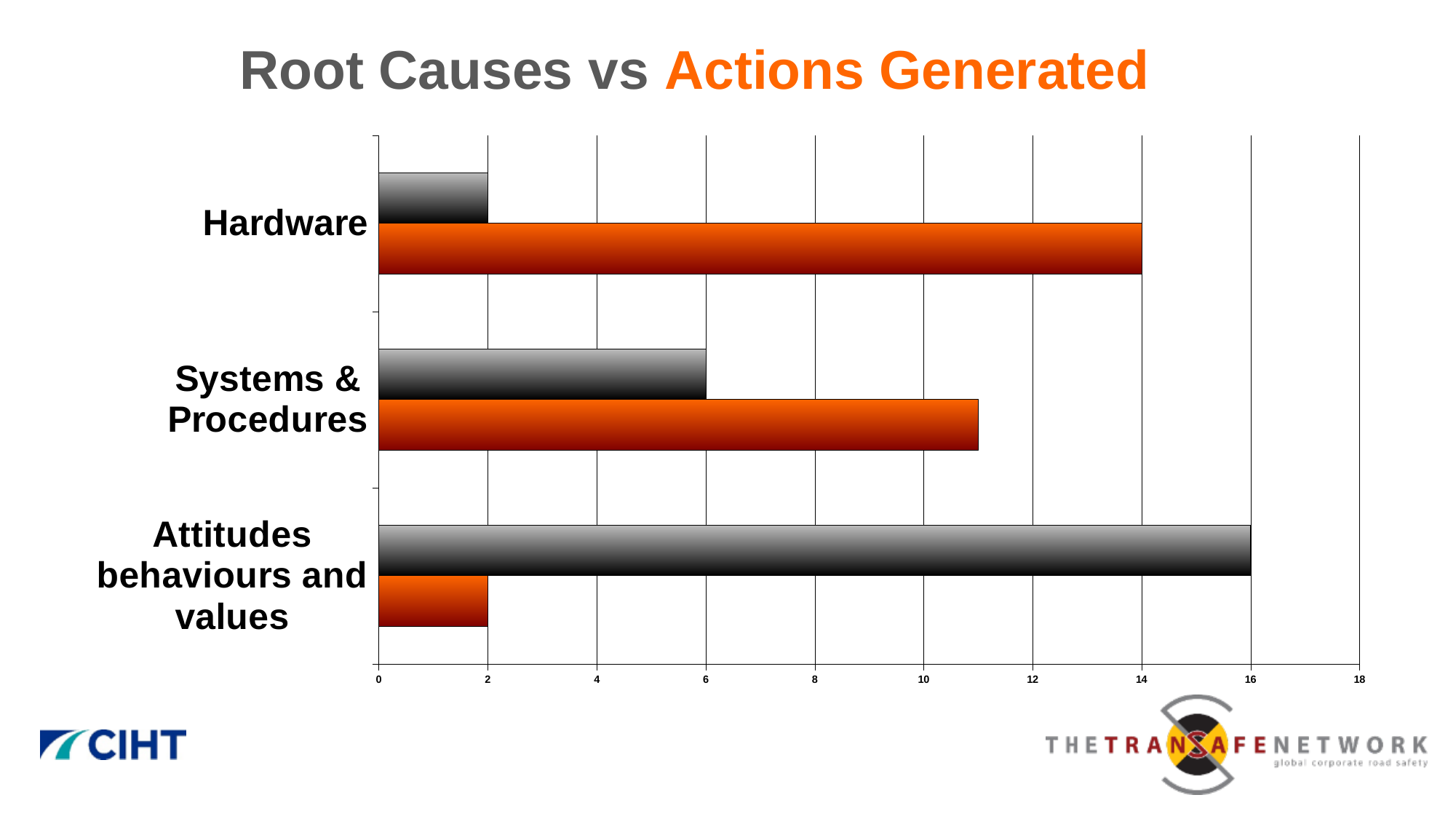
What is the value of the orange bar for Attitudes behaviours and values? 2 Which category has the longest grey bar? Attitudes behaviours and values What is the value of the grey bar for Systems & Procedures? 6 Is the value of the orange bar for Systems & Procedures greater or less than 10? greater What is the value of the grey bar for Hardware? 2 Which category has the shortest orange bar? Attitudes behaviours and values What type of chart is shown on the slide? Bar chart What is the value of the orange bar for Hardware? 14 What is the difference between the orange bar and the grey bar for Hardware? 12 What is the value of the grey bar for Attitudes behaviours and values? 16 How many categories are shown on the chart? 3 Which colour in the chart title corresponds to 'Actions Generated'? Orange